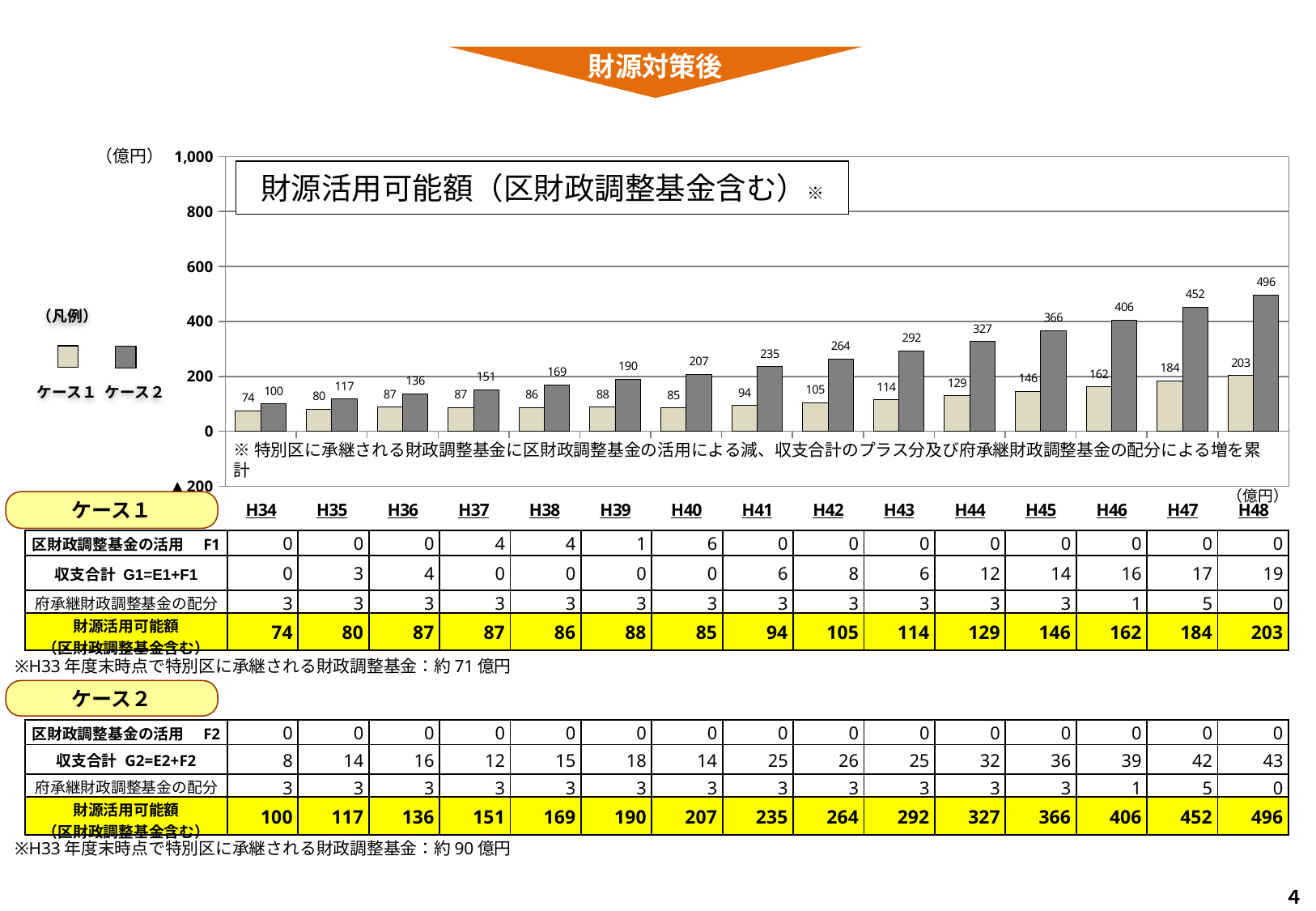
Is the value for ケース2 in H44 greater or less than 200? greater In H42, which is larger, ケース1 or ケース2? ケース2 What is the value for ケース2 in H40? 207 What is the value for ケース1 in H47? 184 How many series does the legend list? 2 In which year does ケース2 reach its highest value? H48 By how much does ケース1 increase from H34 to H48? 129 How many years are shown on the x axis of the chart? 15 What is the difference between ケース2 and ケース1 in H48? 293 In which year is the value for ケース1 the lowest? H34 What kind of chart is shown on the slide? bar chart Do the values for ケース2 rise or fall from H34 to H48? rise